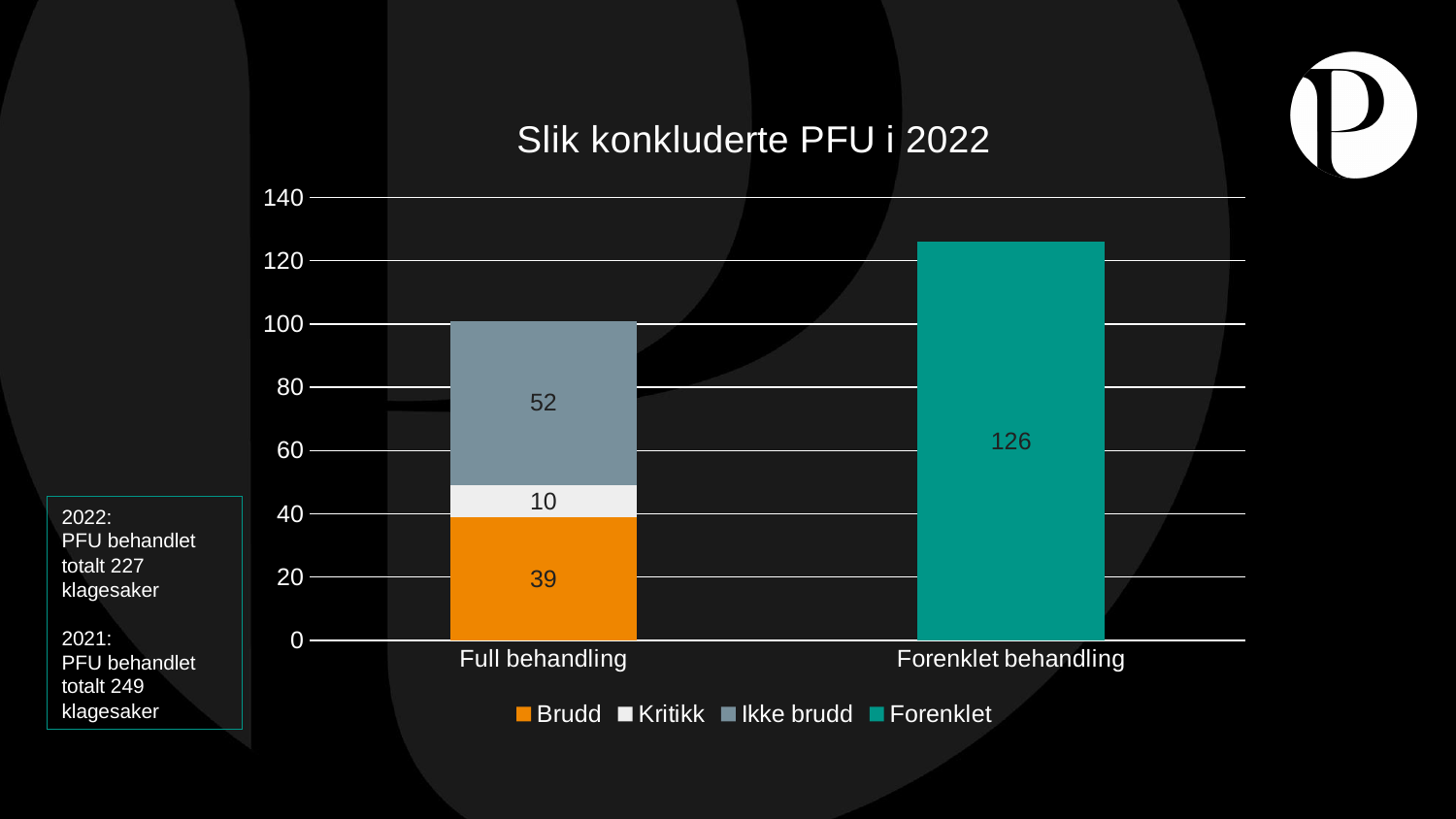
What is the total of the Full behandling stacked bar? 101 What is the value for Forenklet in the Forenklet behandling bar? 126 What is the value for Ikke brudd in the Full behandling bar? 52 Which is larger: the Forenklet value or the Ikke brudd value? Forenklet What is the title of the chart? Slik konkluderte PFU i 2022 Which segment of the Full behandling bar is the largest? Ikke brudd Which segment of the Full behandling bar is the smallest? Kritikk How many series does the legend list? 4 What is the value for Brudd in the Full behandling bar? 39 Is the value for Forenklet behandling greater or less than 120? greater What is the value for Kritikk in the Full behandling bar? 10 What is the difference between the Ikke brudd value and the Brudd value in the Full behandling bar? 13